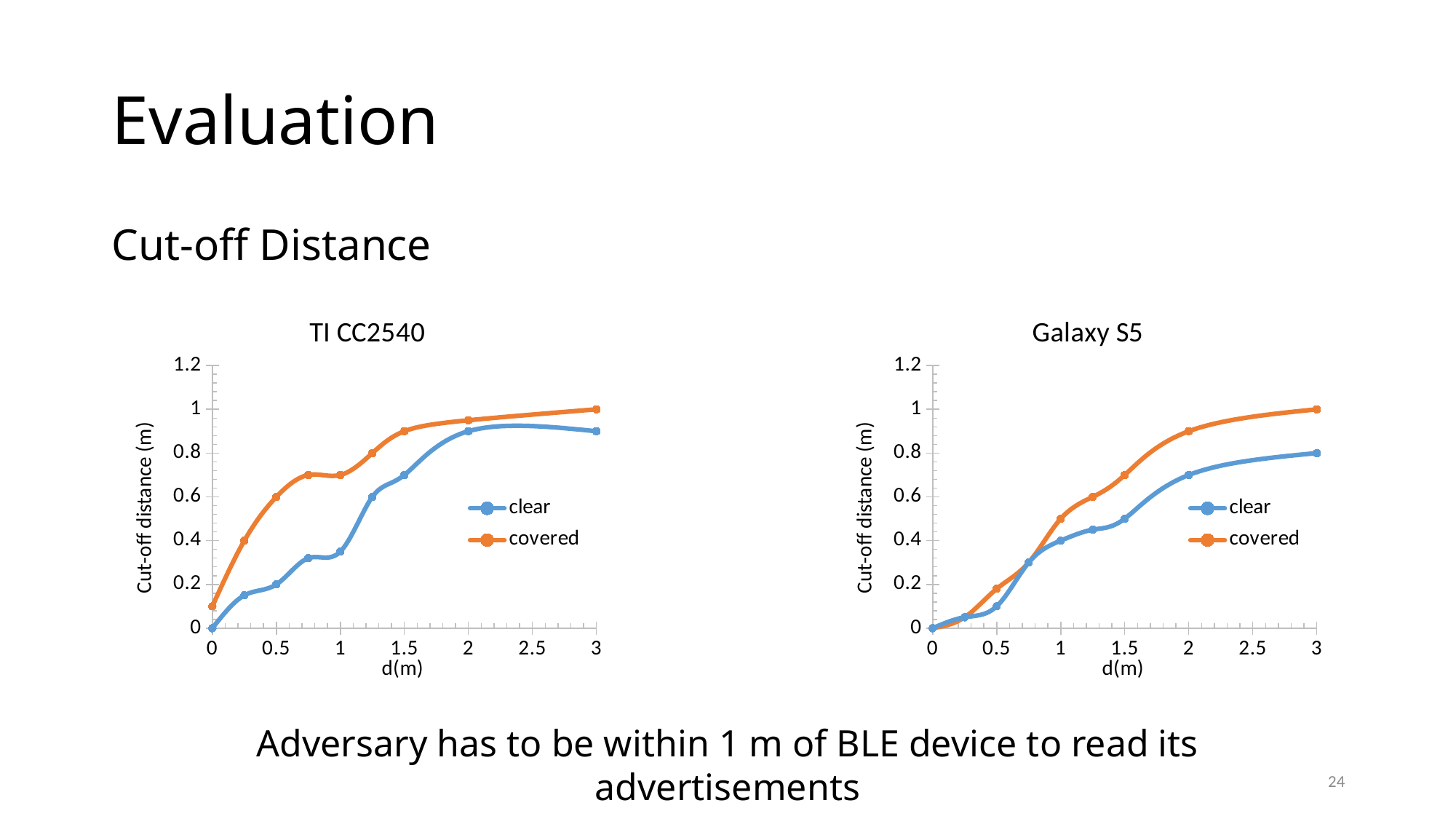
In the Galaxy S5 chart, which series has the larger cut-off distance at d = 3 m, clear or covered? covered In the Galaxy S5 chart, is the covered series value at d = 2 m greater or less than 0.8? greater In the TI CC2540 chart, which series has the larger cut-off distance at d = 1 m, clear or covered? covered In the Galaxy S5 chart, what is the cut-off distance for the clear series at d = 3 m? 0.8 What is the y-axis label of the Galaxy S5 chart? Cut-off distance (m) In the TI CC2540 chart, is the clear series value at d = 2 m greater or less than 0.8? greater In the TI CC2540 chart, what is the cut-off distance for the covered series at d = 3 m? 1 What type of chart is the TI CC2540 chart? line chart In the Galaxy S5 chart, is the clear series value at d = 0.5 m greater or less than 0.2? less In the Galaxy S5 chart, what is the cut-off distance for the covered series at d = 3 m? 1 In the TI CC2540 chart, does the covered series generally rise or fall as d increases? rise How many series does the legend of the Galaxy S5 chart list? 2